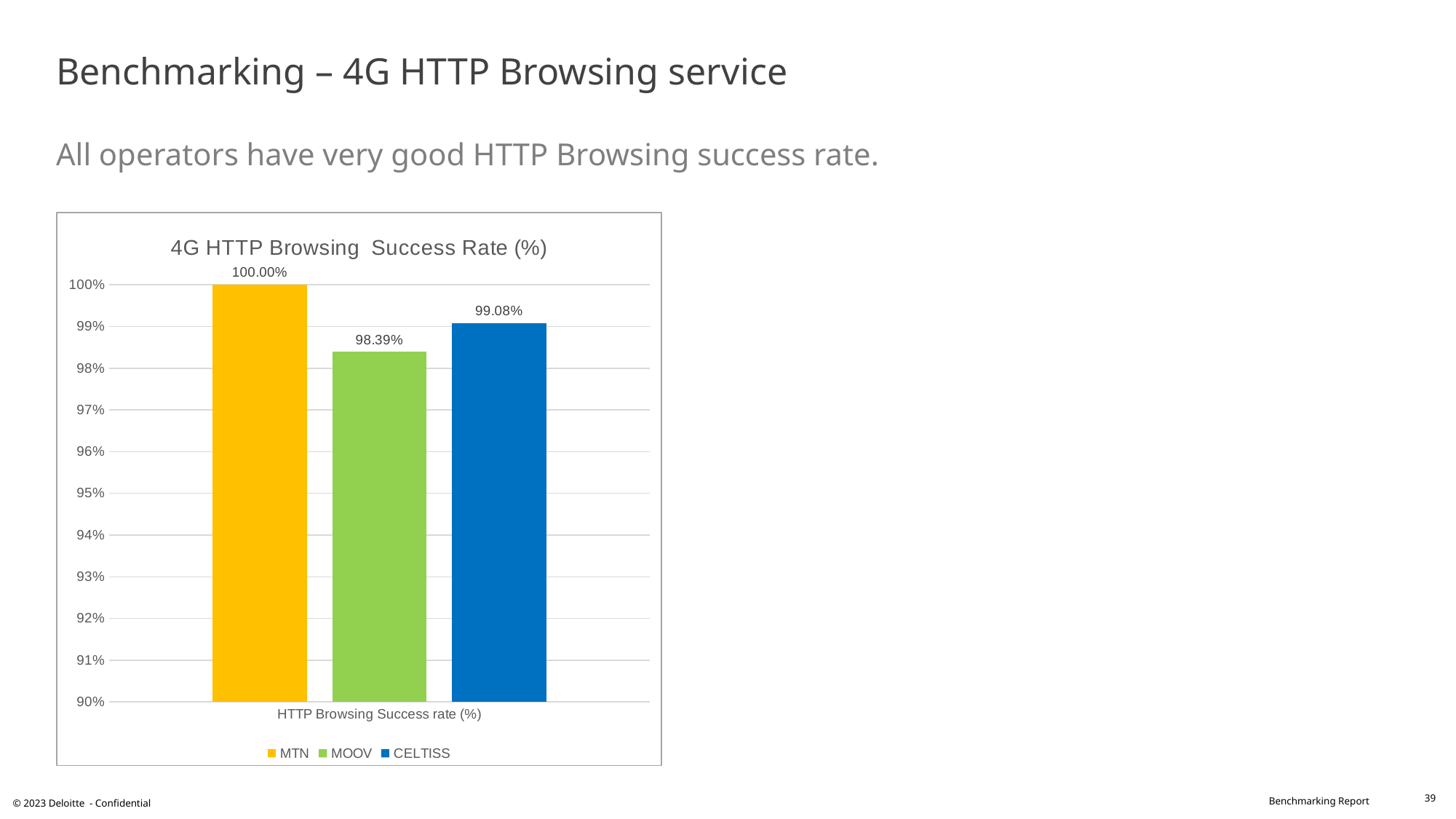
What is the title of the chart? 4G HTTP Browsing Success Rate (%) What is the difference between CELTISS's and MOOV's 4G HTTP Browsing success rates? 0.69% Which operator has the highest 4G HTTP Browsing success rate? MTN How many series does the legend list? 3 Is the value for MOOV greater or less than 99%? less Which operator has the lowest 4G HTTP Browsing success rate? MOOV What is the difference between MTN's and MOOV's 4G HTTP Browsing success rates? 1.61% What is the 4G HTTP Browsing success rate for MTN? 100.00% What kind of chart is shown on the slide? Bar chart Which has a higher 4G HTTP Browsing success rate, CELTISS or MOOV? CELTISS What is the 4G HTTP Browsing success rate for CELTISS? 99.08% What is the 4G HTTP Browsing success rate for MOOV? 98.39%